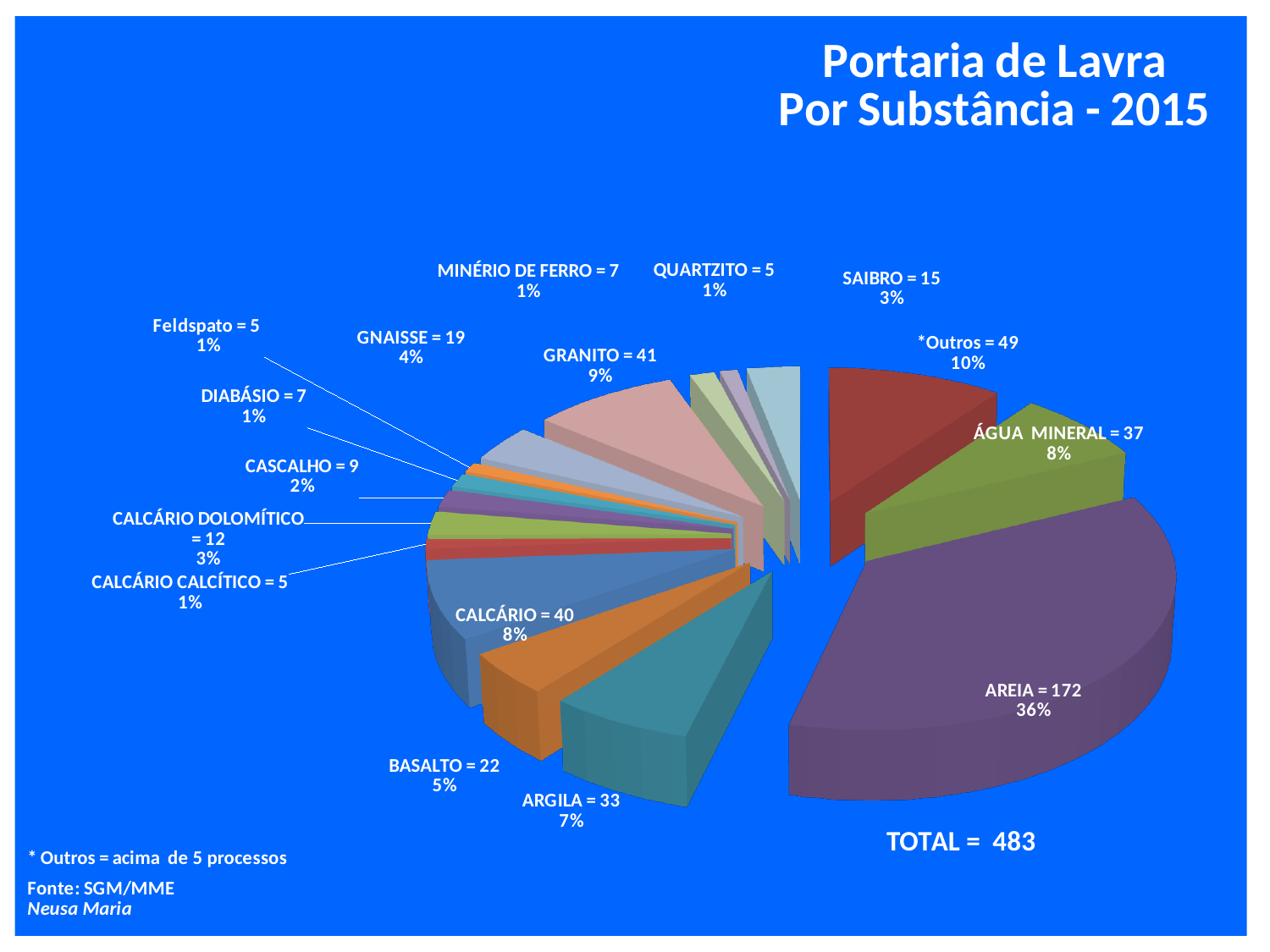
What is the value for *Outros? 49 What is the difference between the values for AREIA and *Outros? 123 What kind of chart is shown on the slide? pie chart Which is larger, the value for ÁGUA MINERAL or the value for ARGILA? ÁGUA MINERAL What is the value for GRANITO? 41 How many substance categories are shown in the pie chart? 16 What is the difference between the values for GRANITO and CALCÁRIO? 1 What TOTAL is printed on the slide? 483 What is the value for AREIA? 172 Which substance has the largest slice of the pie? AREIA What share of the pie does AREIA represent? 36% What share of the pie does GNAISSE represent? 4%